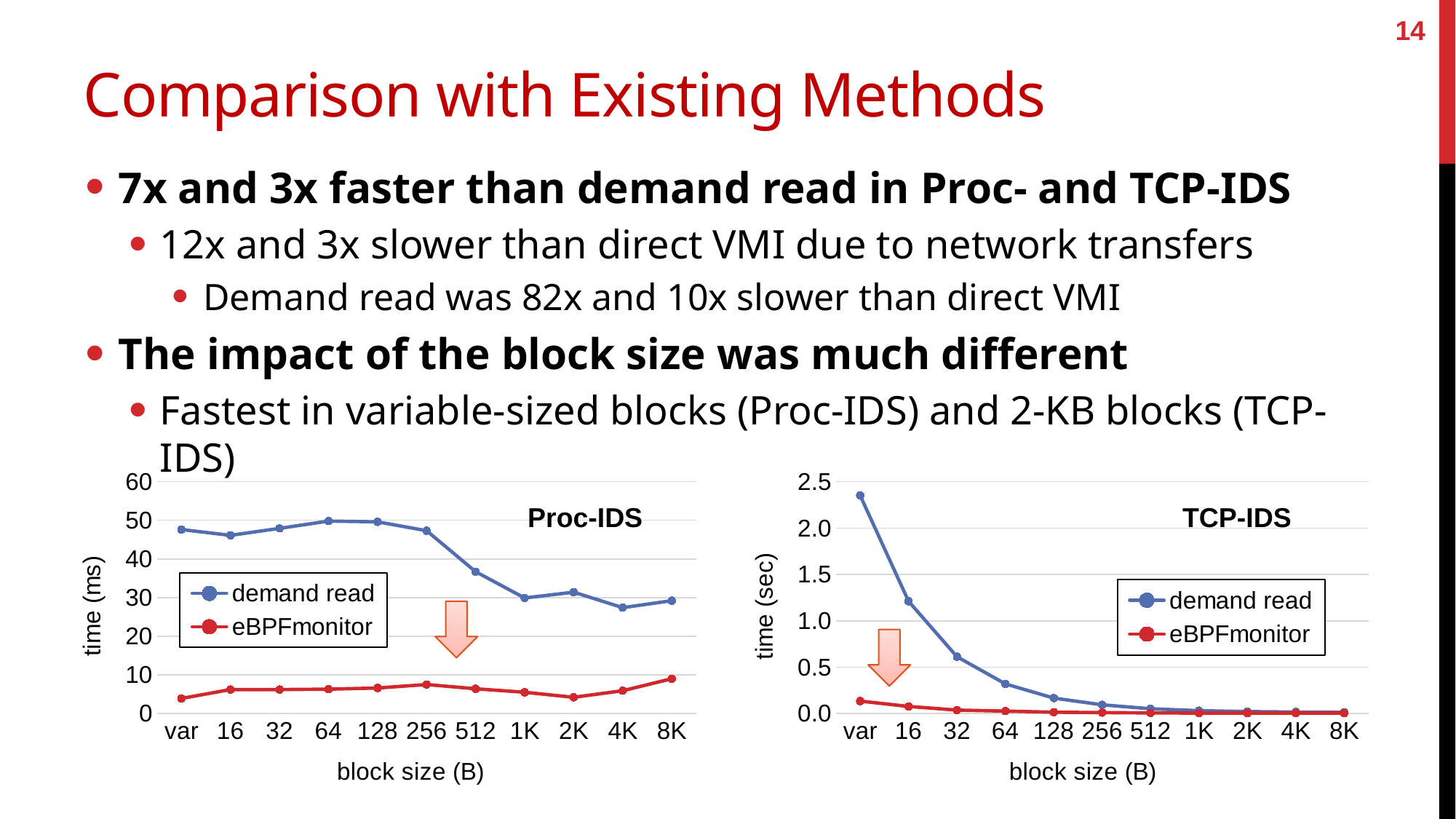
What kind of chart is the Proc-IDS chart? line chart In the Proc-IDS chart, is the demand read value for 512 greater or less than 30? greater In the TCP-IDS chart, is the demand read value for 64 greater or less than 0.5? less What is the y-axis label of the TCP-IDS chart? time (sec) What colour is the eBPFmonitor line in the Proc-IDS chart? red In the Proc-IDS chart, which series has the larger value at block size 16, demand read or eBPFmonitor? demand read In the TCP-IDS chart, is the demand read value for var greater or less than 2.0? greater How many series does the legend of the Proc-IDS chart list? 2 In the TCP-IDS chart, at which block size is the demand read time highest? var In the TCP-IDS chart, does the demand read time rise or fall as block size increases from var to 8K? fall How many block size categories are shown on the x axis of the TCP-IDS chart? 11